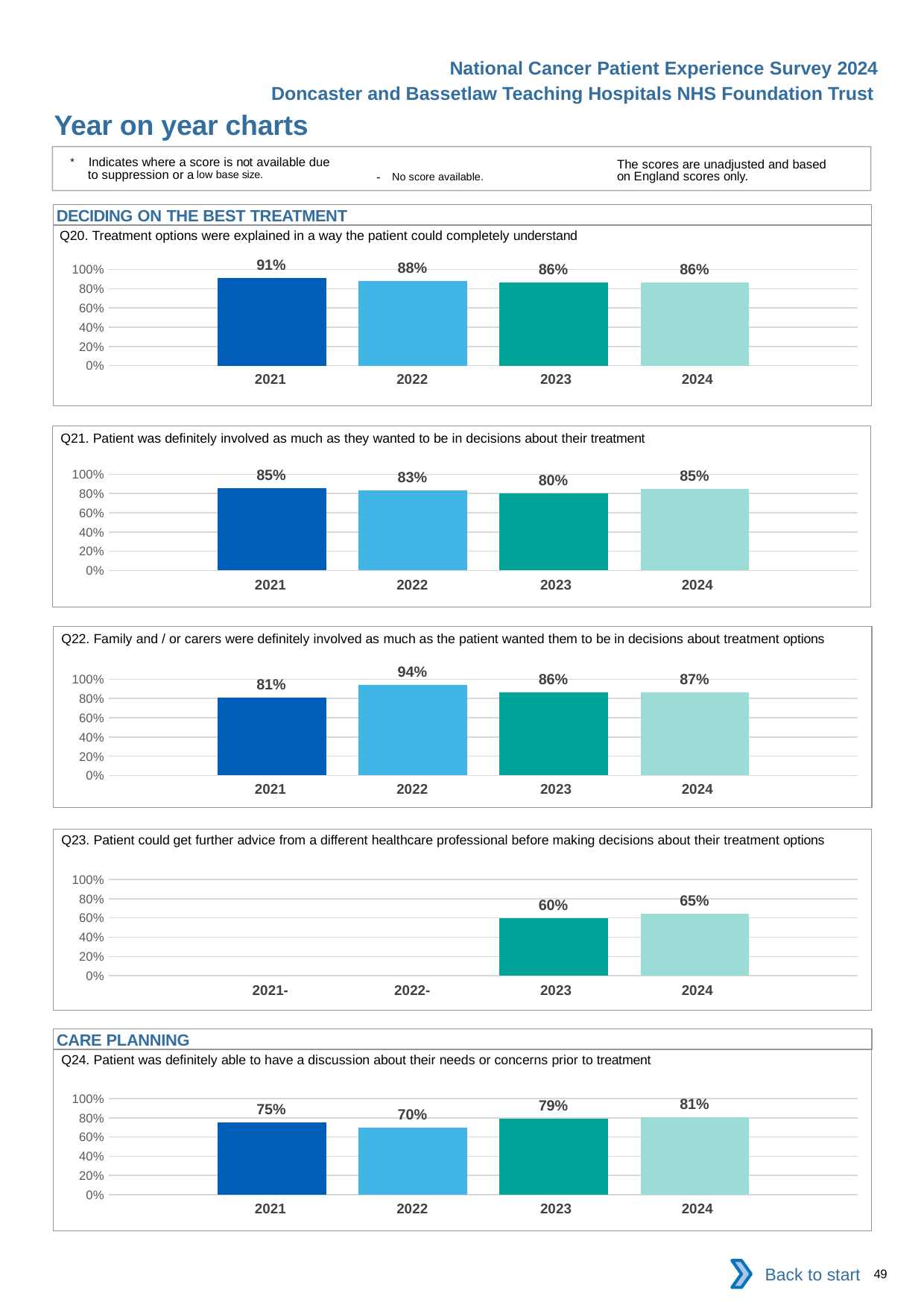
What kind of chart is used for Q21? bar chart In the Q20 chart, do the values rise or fall from 2021 to 2023? fall In the Q24 chart (Patient was definitely able to have a discussion about their needs or concerns prior to treatment), which is larger, the 2022 value or the 2023 value? 2023 In the Q22 chart, what is the difference between the 2022 value and the 2021 value? 13 percentage points In the Q23 chart, how many years have a bar plotted? 2 In the Q21 chart, what is the value for 2024? 85% How many charts are shown on the slide? 5 In the Q24 chart, what is the difference between the 2024 value and the 2021 value? 6 percentage points In the Q21 chart (Patient was definitely involved as much as they wanted to be in decisions about their treatment), which year has the lowest value? 2023 In the Q20 chart (Treatment options were explained in a way the patient could completely understand), what is the value for 2021? 91% In the Q23 chart (Patient could get further advice from a different healthcare professional), what is the value for 2024? 65% In the Q22 chart (Family and / or carers were definitely involved as much as the patient wanted them to be), which year has the highest value? 2022